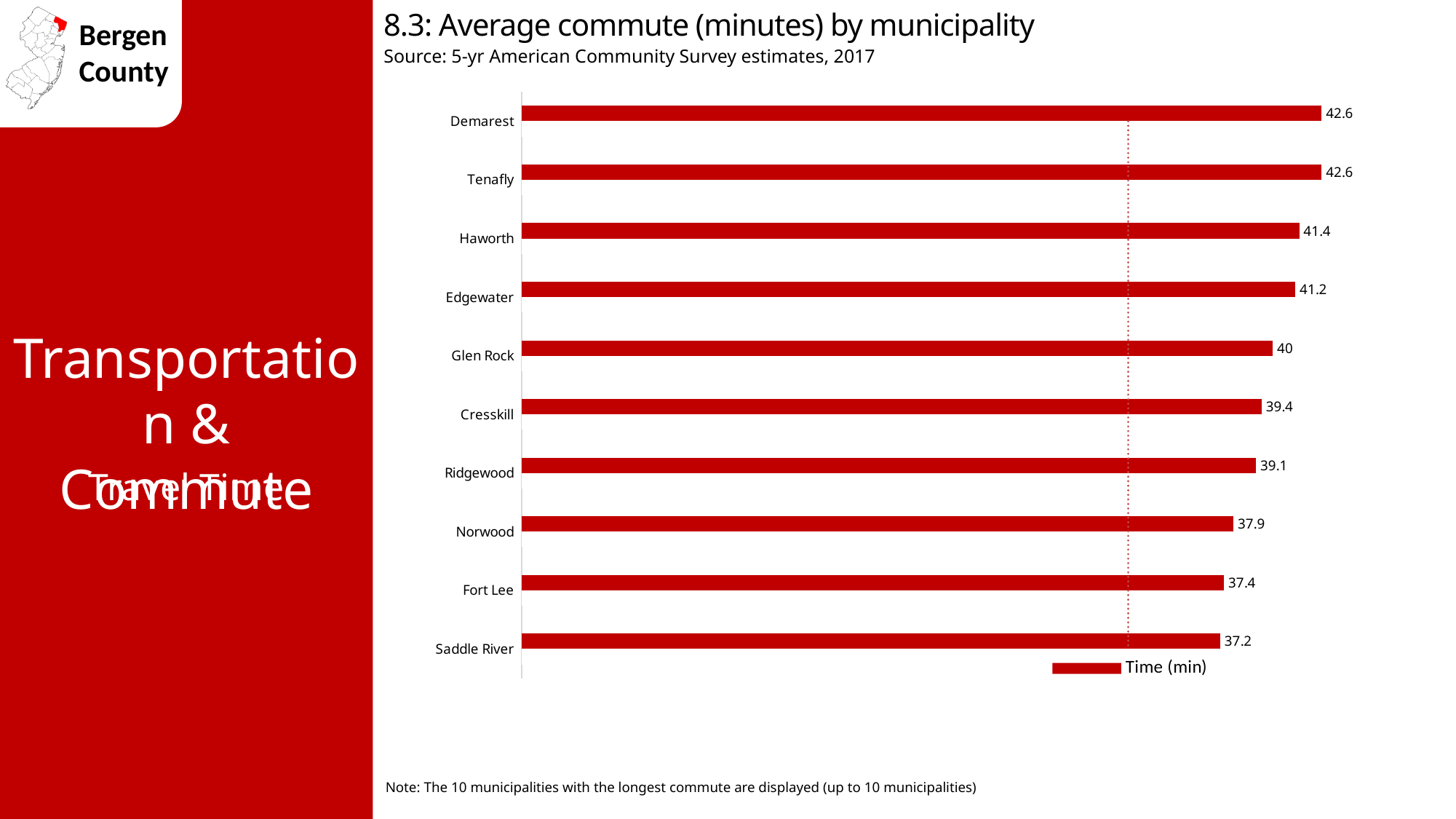
What is the average commute time for Glen Rock? 40 What kind of chart is shown on the slide? Bar chart What is the average commute time for Fort Lee? 37.4 What is the difference in average commute time between Demarest and Saddle River? 5.4 How many municipalities are shown on the chart? 10 What is the average commute time for Haworth? 41.4 Which has a longer average commute, Cresskill or Ridgewood? Cresskill What is the difference in average commute time between Edgewater and Norwood? 3.3 What is the legend entry for the series shown on the chart? Time (min) How many series does the legend list? 1 Which has a longer average commute, Norwood or Haworth? Haworth Which municipality has the shortest average commute shown on the chart? Saddle River